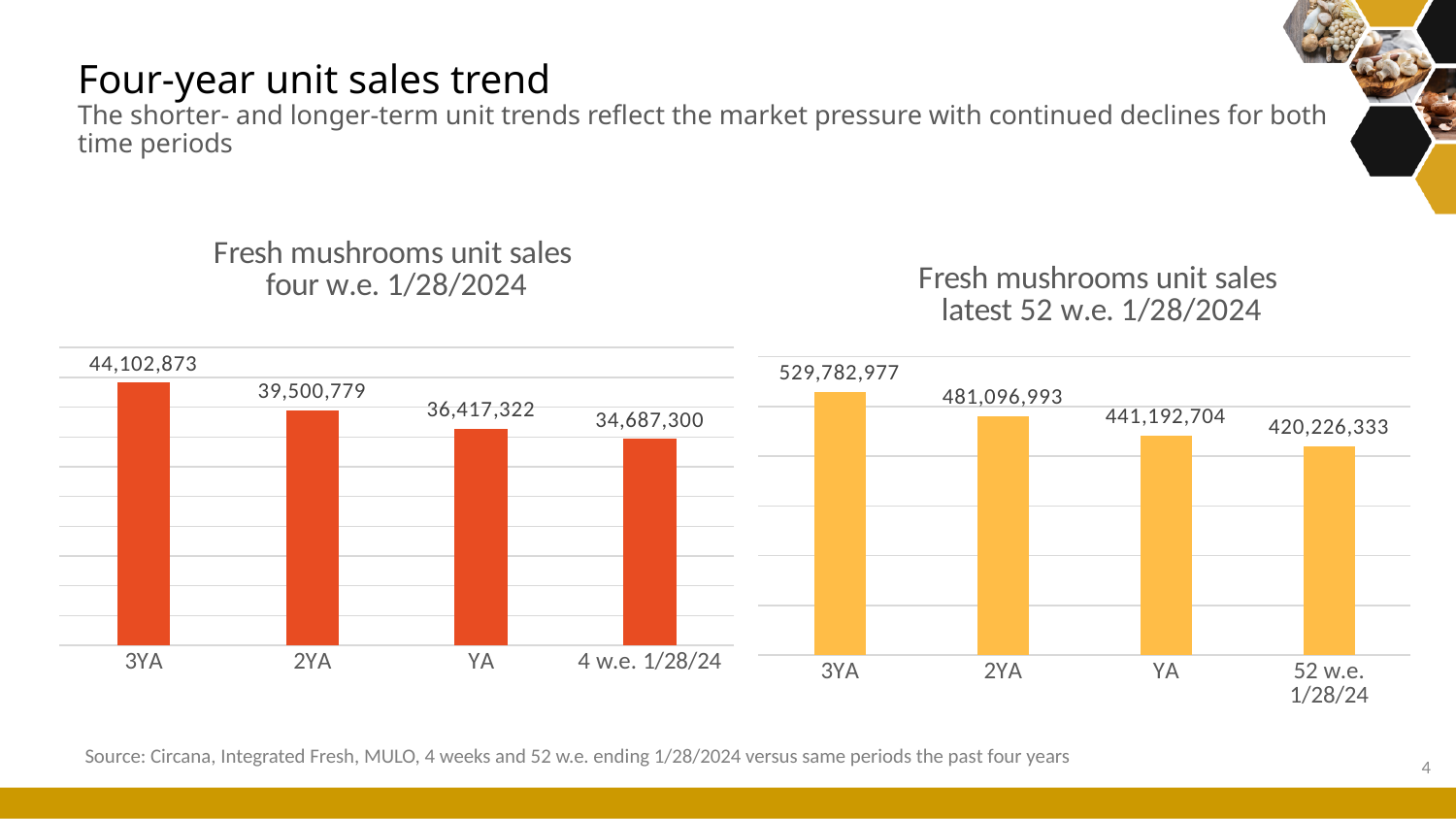
What type of chart is the 'Fresh mushrooms unit sales four w.e. 1/28/2024' chart? Bar chart In the 'Fresh mushrooms unit sales latest 52 w.e. 1/28/2024' chart, what is the value for 52 w.e. 1/28/24? 420,226,333 In the 'Fresh mushrooms unit sales four w.e. 1/28/2024' chart, what is the difference between the 3YA value and the 4 w.e. 1/28/24 value? 9,415,573 In the 'Fresh mushrooms unit sales four w.e. 1/28/2024' chart, which category has the highest value? 3YA In the 'Fresh mushrooms unit sales latest 52 w.e. 1/28/2024' chart, what is the value for YA? 441,192,704 In the 'Fresh mushrooms unit sales four w.e. 1/28/2024' chart, what is the value for 4 w.e. 1/28/24? 34,687,300 How many categories are shown in the 'Fresh mushrooms unit sales latest 52 w.e. 1/28/2024' chart? 4 In the 'Fresh mushrooms unit sales latest 52 w.e. 1/28/2024' chart, which category has the lowest value? 52 w.e. 1/28/24 In the 'Fresh mushrooms unit sales latest 52 w.e. 1/28/2024' chart, do the values rise or fall from 3YA to 52 w.e. 1/28/24? Fall In the 'Fresh mushrooms unit sales four w.e. 1/28/2024' chart, what is the value for 3YA? 44,102,873 In the 'Fresh mushrooms unit sales four w.e. 1/28/2024' chart, which is larger, the value for 2YA or the value for YA? 2YA In the 'Fresh mushrooms unit sales latest 52 w.e. 1/28/2024' chart, what is the difference between the 2YA value and the YA value? 39,904,289